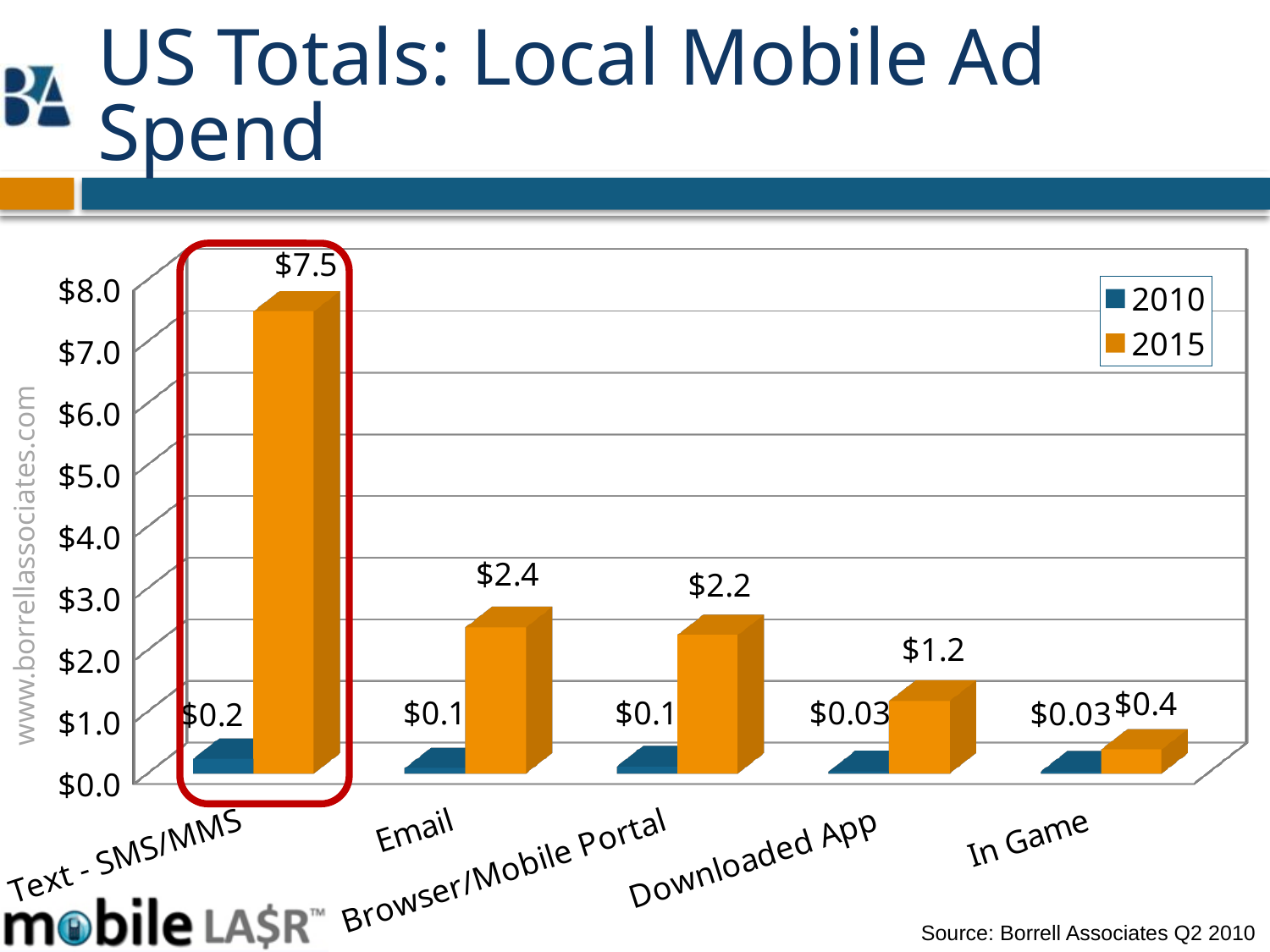
What is the 2010 value for In Game? $0.03 What kind of chart is shown on the slide? Bar chart Which is larger, the 2015 value for Email or the 2015 value for Browser/Mobile Portal? Email How many series does the legend list? 2 What is the 2010 value for Email? $0.1 Which series is shown in orange in the legend? 2015 What is the difference between the 2015 and 2010 values for Browser/Mobile Portal? $2.1 Which category has the highest 2015 value? Text - SMS/MMS What is the 2015 value for Downloaded App? $1.2 What is the 2015 value for Text - SMS/MMS? $7.5 Which category has the lowest 2015 value? In Game How many categories are shown on the x axis? 5